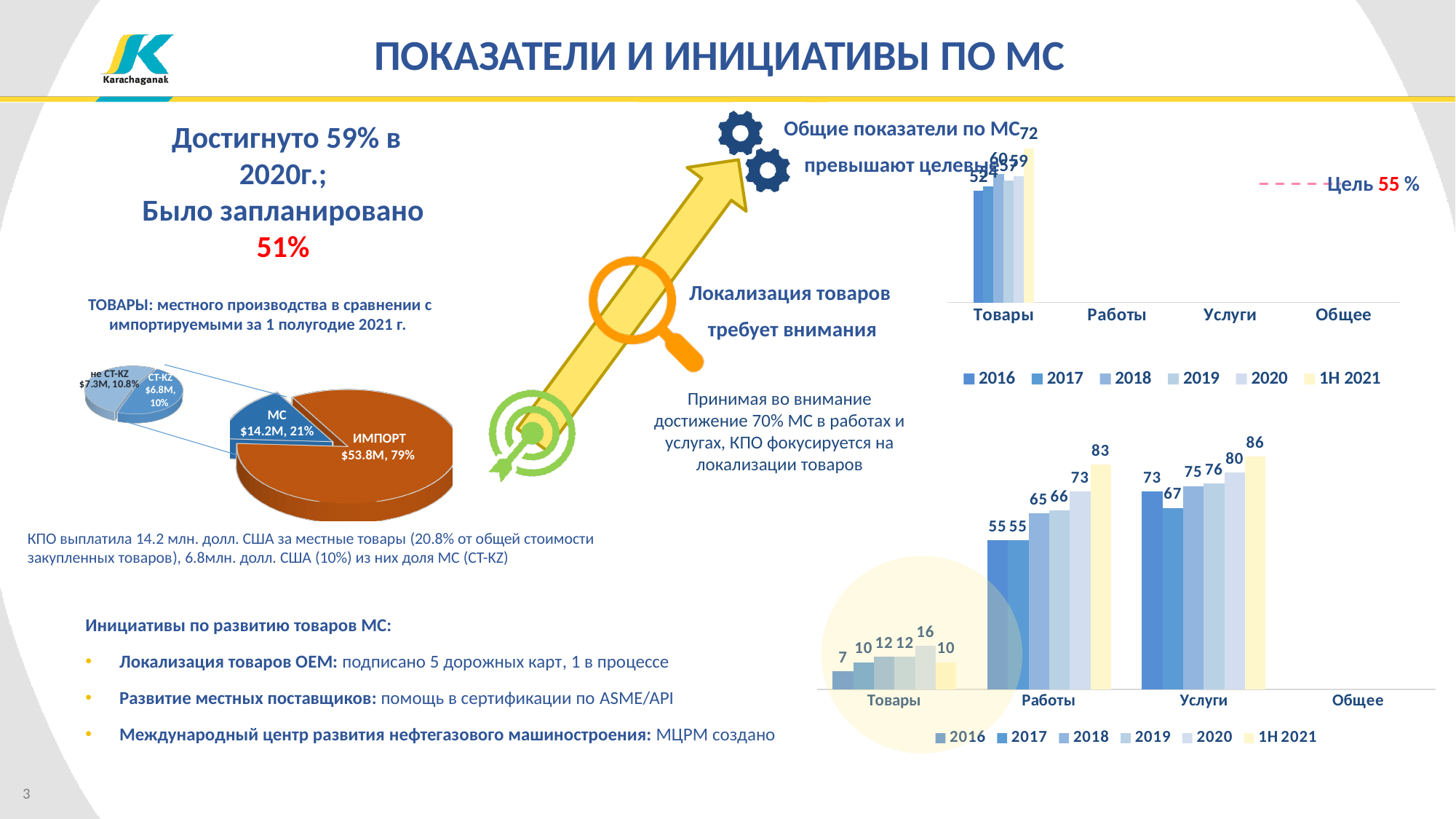
In the bottom-right bar chart, which is larger: Работы in 2020 or Услуги in 2020? Услуги in 2020 In the pie chart on the left, what is the share of ИМПОРТ? 79% In the bottom-right bar chart, do the values for Работы rise or fall from 2016 to 1Н 2021? rise In the bottom-right bar chart, what is the value for Услуги in 2017? 67 In the bottom-right bar chart, what is the difference between the Услуги and Работы values for 1Н 2021? 3 In the bottom-right bar chart, what is the value for Товары in 2020? 16 How many series does the legend of the bottom-right bar chart list? 6 In the bottom-right bar chart, which year has the lowest value for Товары? 2016 In the pie chart on the left, what is the value shown for МС? $14.2M, 21% In the bottom-right bar chart, which year has the highest value for Услуги? 1Н 2021 What target value is shown by the dashed line in the top-right chart? Цель 55 % In the bottom-right bar chart, what is the value for Работы in 1Н 2021? 83